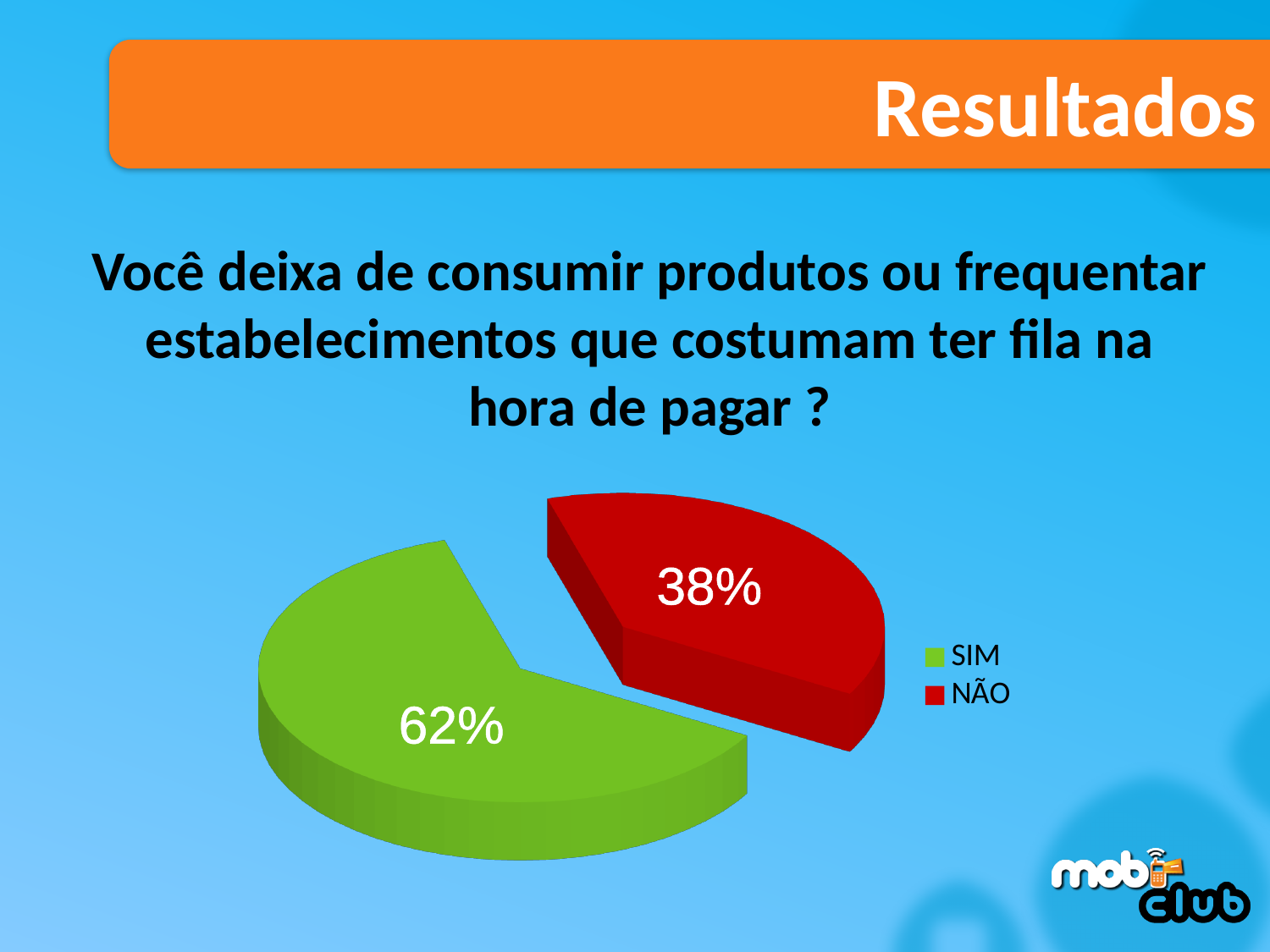
What is the difference in percentage points between SIM and NÃO? 24 What percentage of respondents answered NÃO? 38% Which response has the smallest share of the pie? NÃO How many entries does the legend list? 2 How many slices does the pie chart have? 2 Which response has the largest share of the pie? SIM What share of the pie does the SIM slice represent? 62% What kind of chart is shown on the slide? Pie chart What percentage of respondents answered SIM? 62% What colour is the NÃO slice? Red What colour is the SIM slice? Green Which is larger, the share for SIM or the share for NÃO? SIM